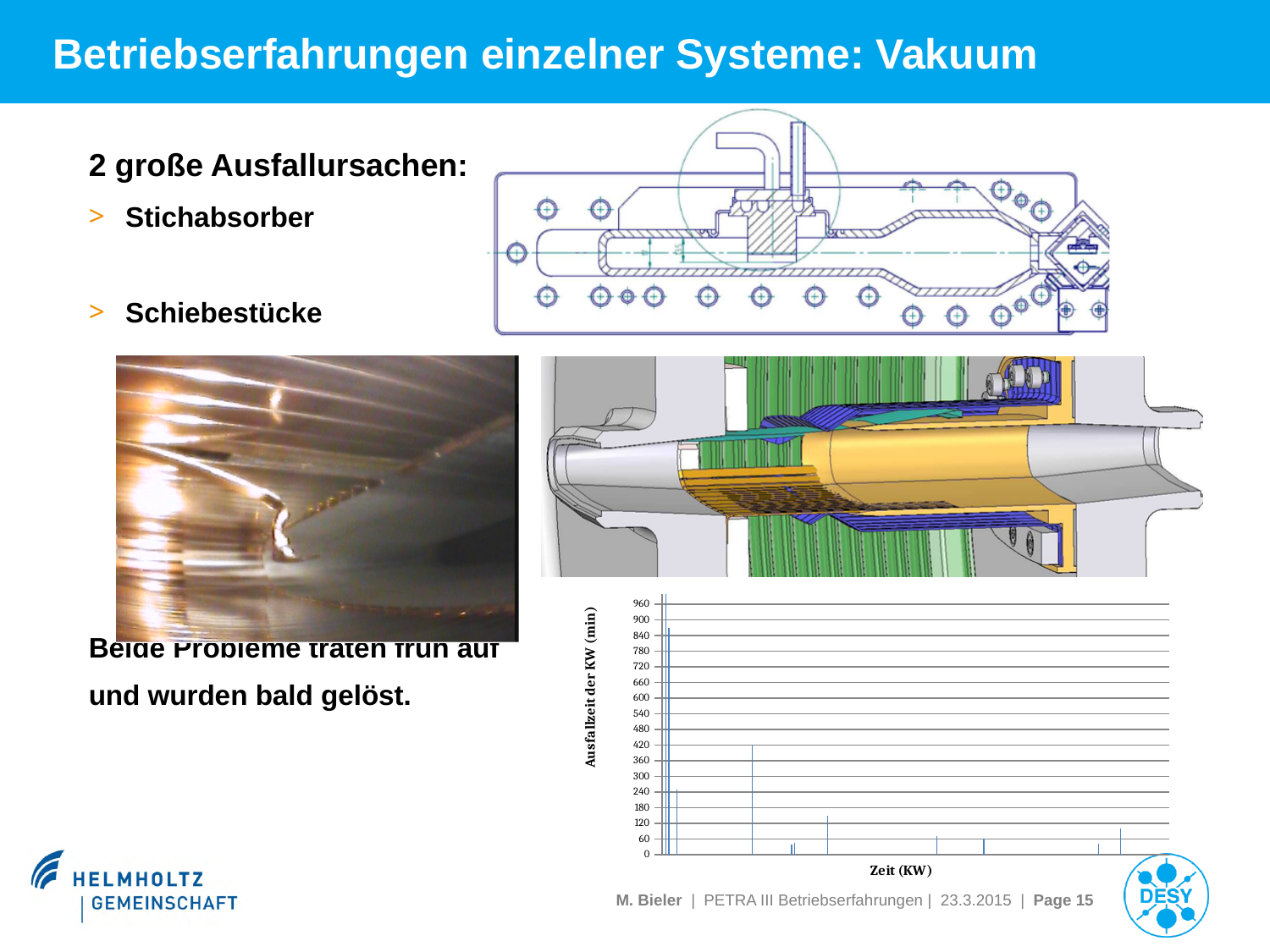
In the chart at the bottom right, is the value of the third-tallest bar greater or less than 480? less In the chart at the bottom right, what is the highest value shown on the vertical axis? 960 In the chart at the bottom right, is the value of the tallest bar greater or less than 600? greater In the chart at the bottom right, is the tallest bar located in the left half or the right half of the x axis? left half In the chart at the bottom right, do the downtime values generally rise or fall from left to right along the x axis? fall What kind of chart is shown at the bottom right of the slide? bar chart What is the title of the vertical axis of the chart at the bottom right? Ausfallzeit der KW (min) In the chart at the bottom right, what is the lowest value shown on the vertical axis? 0 What is the title of the horizontal axis of the chart at the bottom right? Zeit (KW) In the chart at the bottom right, is the value of the third-tallest bar greater or less than 300? greater